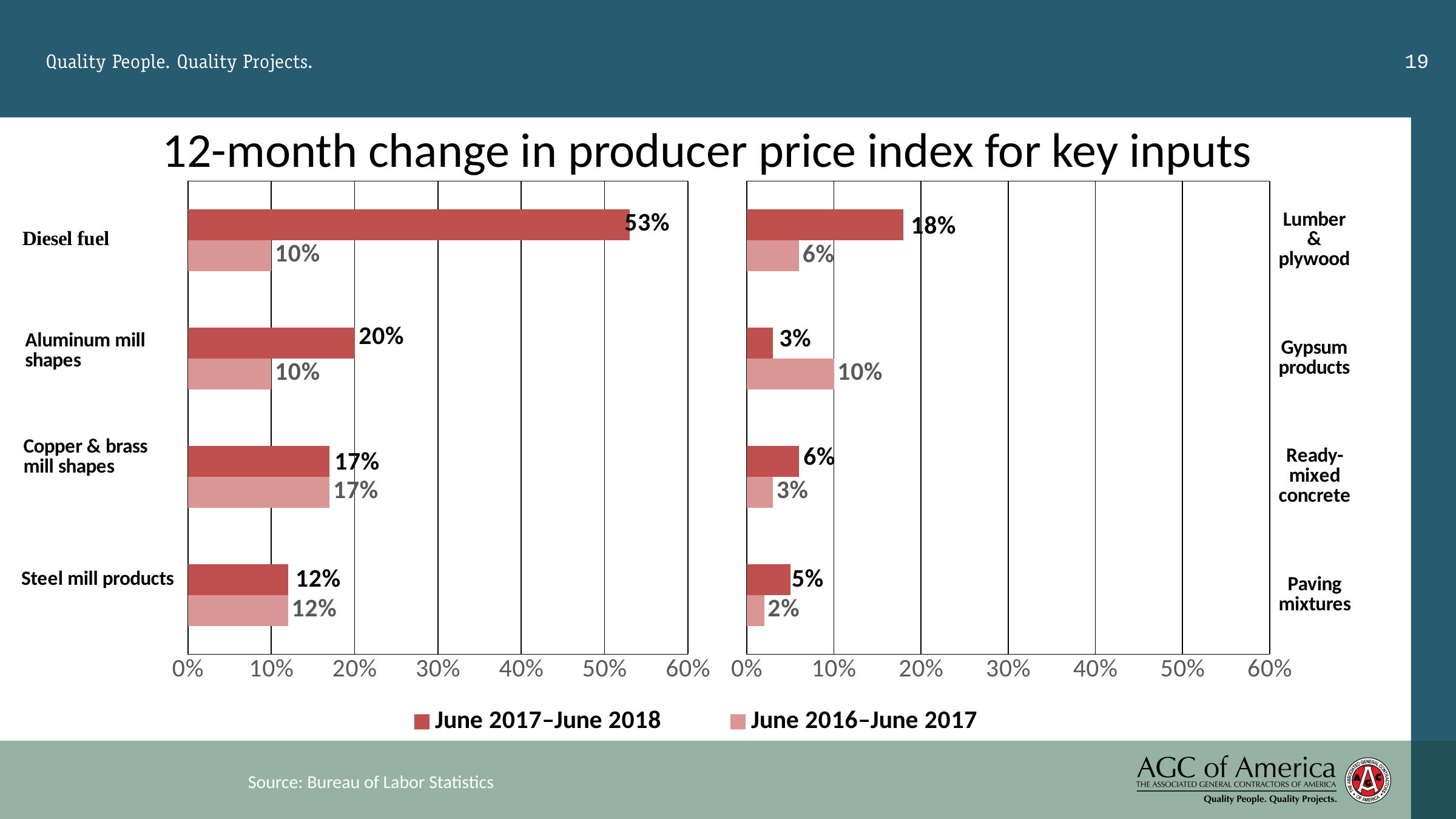
What kind of chart is used on this slide? Bar chart What is the title of the chart on the slide? 12-month change in producer price index for key inputs In the left chart, which category has the highest June 2017–June 2018 value? Diesel fuel How many series does the legend list? 2 In the right chart, what is the June 2017–June 2018 value for Lumber & plywood? 18% How many categories are shown in the right chart? 4 In the left chart, what is the difference between the June 2017–June 2018 and June 2016–June 2017 values for Diesel fuel? 43% In the right chart, which category has the lowest June 2016–June 2017 value? Paving mixtures In the right chart, which is larger for Gypsum products: the June 2017–June 2018 value or the June 2016–June 2017 value? June 2016–June 2017 In the left chart, is the June 2017–June 2018 value for Aluminum mill shapes greater or less than 10%? greater In the left chart, what is the June 2017–June 2018 value for Diesel fuel? 53% In the right chart, what is the June 2016–June 2017 value for Gypsum products? 10%